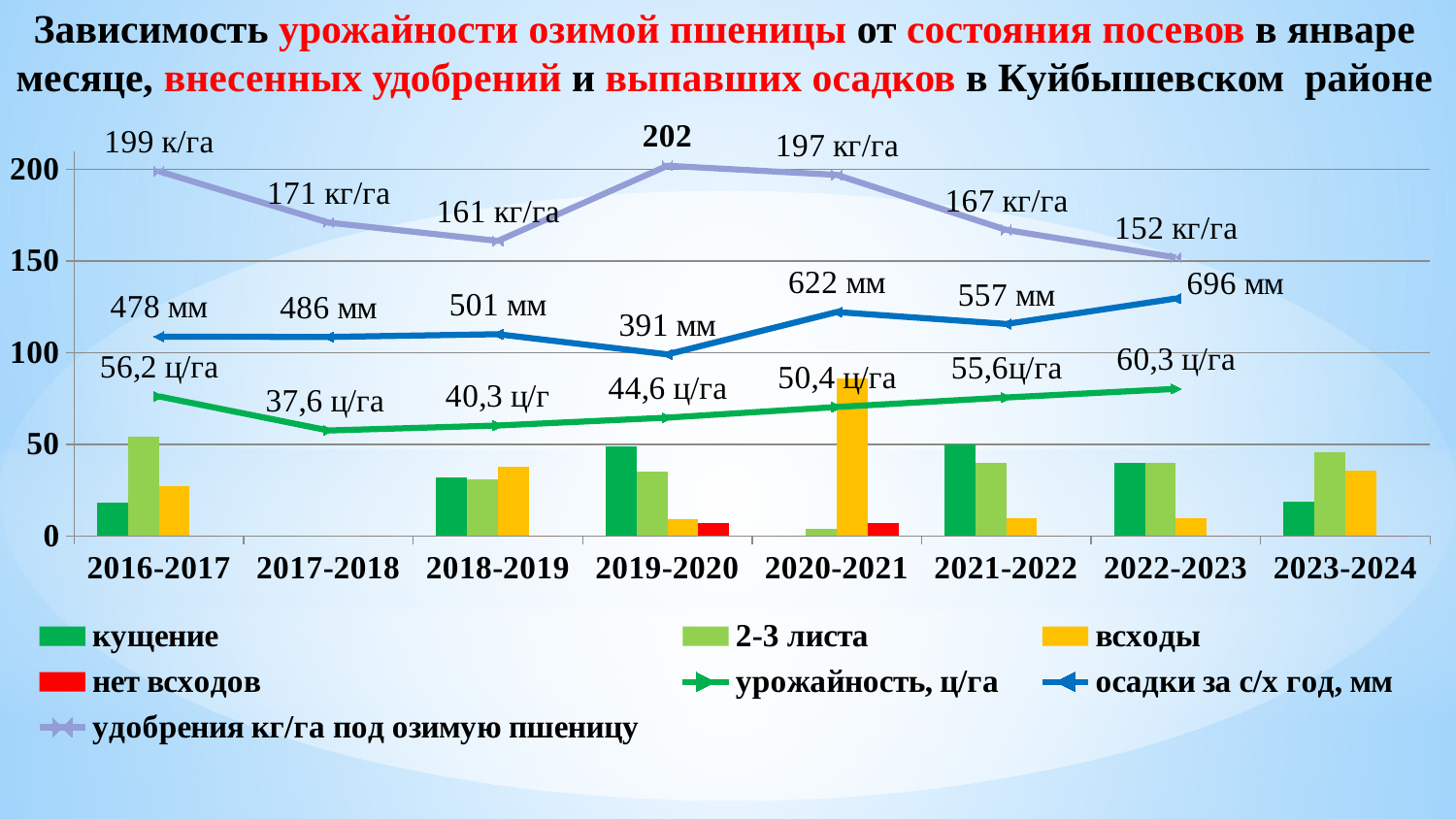
What is the yield (урожайность) value shown for 2016-2017? 56,2 ц/га What is the fertilizer (удобрения) value shown for 2022-2023? 152 кг/га How many series does the legend list? 7 How many seasons are shown on the x axis? 8 Is the value of the 'всходы' bar for 2020-2021 greater or less than 50? greater In which season is the yield (урожайность) value the lowest? 2017-2018 What is the precipitation (осадки) value shown for 2019-2020? 391 мм Which season has higher precipitation: 2020-2021 or 2021-2022? 2020-2021 In which season is the precipitation (осадки) value the highest? 2022-2023 In which season is the fertilizer (удобрения) value the highest? 2019-2020